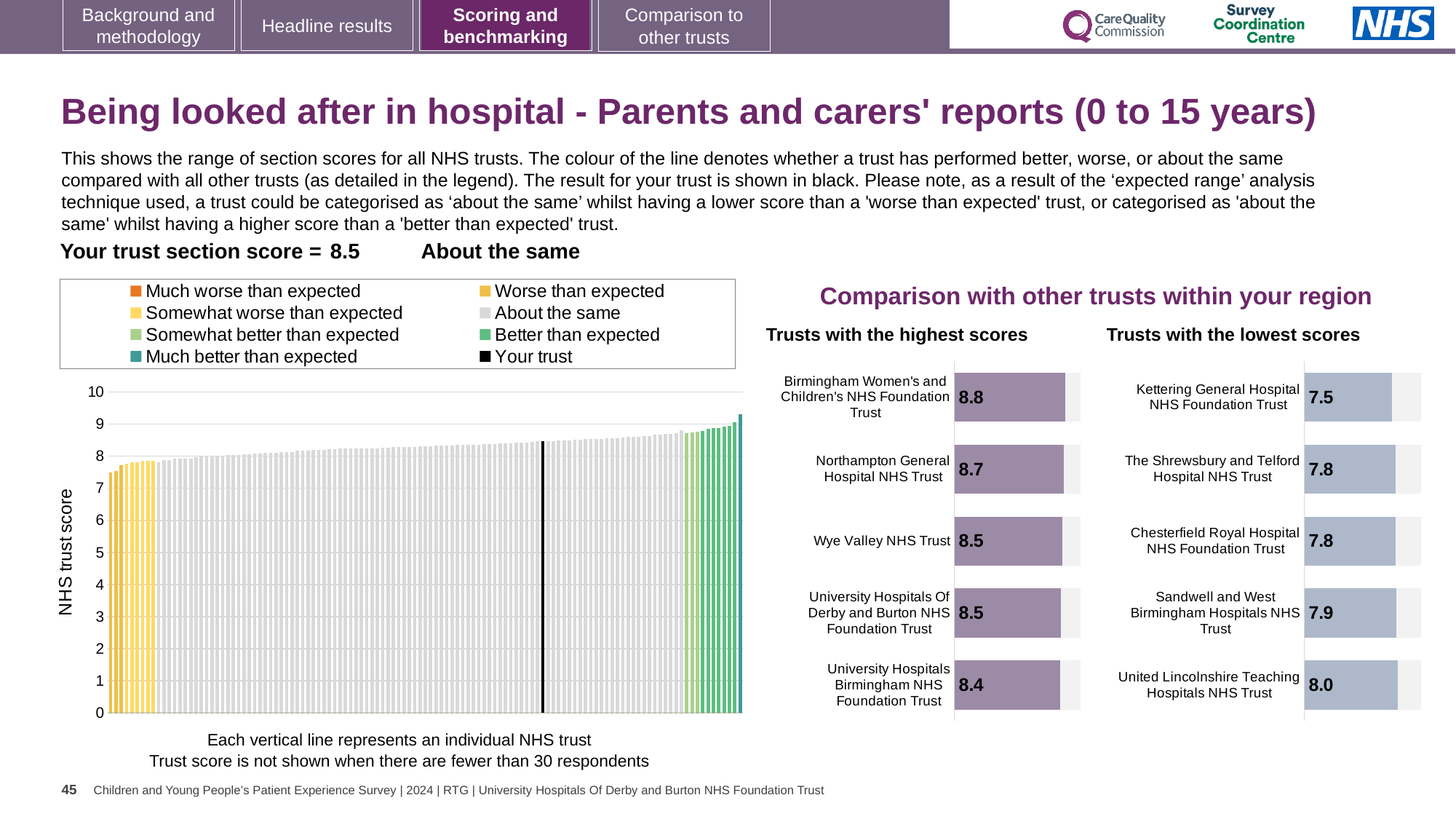
What kind of chart is the left-hand chart showing the range of section scores for all NHS trusts? Bar chart How many trusts are shown in the 'Trusts with the lowest scores' chart? 5 In the 'Trusts with the lowest scores' chart, which has the larger score: Sandwell and West Birmingham Hospitals NHS Trust or Kettering General Hospital NHS Foundation Trust? Sandwell and West Birmingham Hospitals NHS Trust In the 'Trusts with the highest scores' chart, what is the score for Birmingham Women's and Children's NHS Foundation Trust? 8.8 In the left-hand chart showing the range of section scores, do the values rise or fall from left to right? Rise In the 'Trusts with the highest scores' chart, which trust has the lowest score? University Hospitals Birmingham NHS Foundation Trust In the 'Trusts with the highest scores' chart, what is the difference between the scores of Birmingham Women's and Children's NHS Foundation Trust and University Hospitals Birmingham NHS Foundation Trust? 0.4 In the 'Trusts with the lowest scores' chart, what is the score for United Lincolnshire Teaching Hospitals NHS Trust? 8.0 In the 'Trusts with the lowest scores' chart, what is the score for Kettering General Hospital NHS Foundation Trust? 7.5 How many entries does the legend of the left-hand chart (range of section scores) list? 8 In the 'Trusts with the highest scores' chart, what is the score for Northampton General Hospital NHS Trust? 8.7 In the 'Trusts with the lowest scores' chart, which trust has the highest score? United Lincolnshire Teaching Hospitals NHS Trust